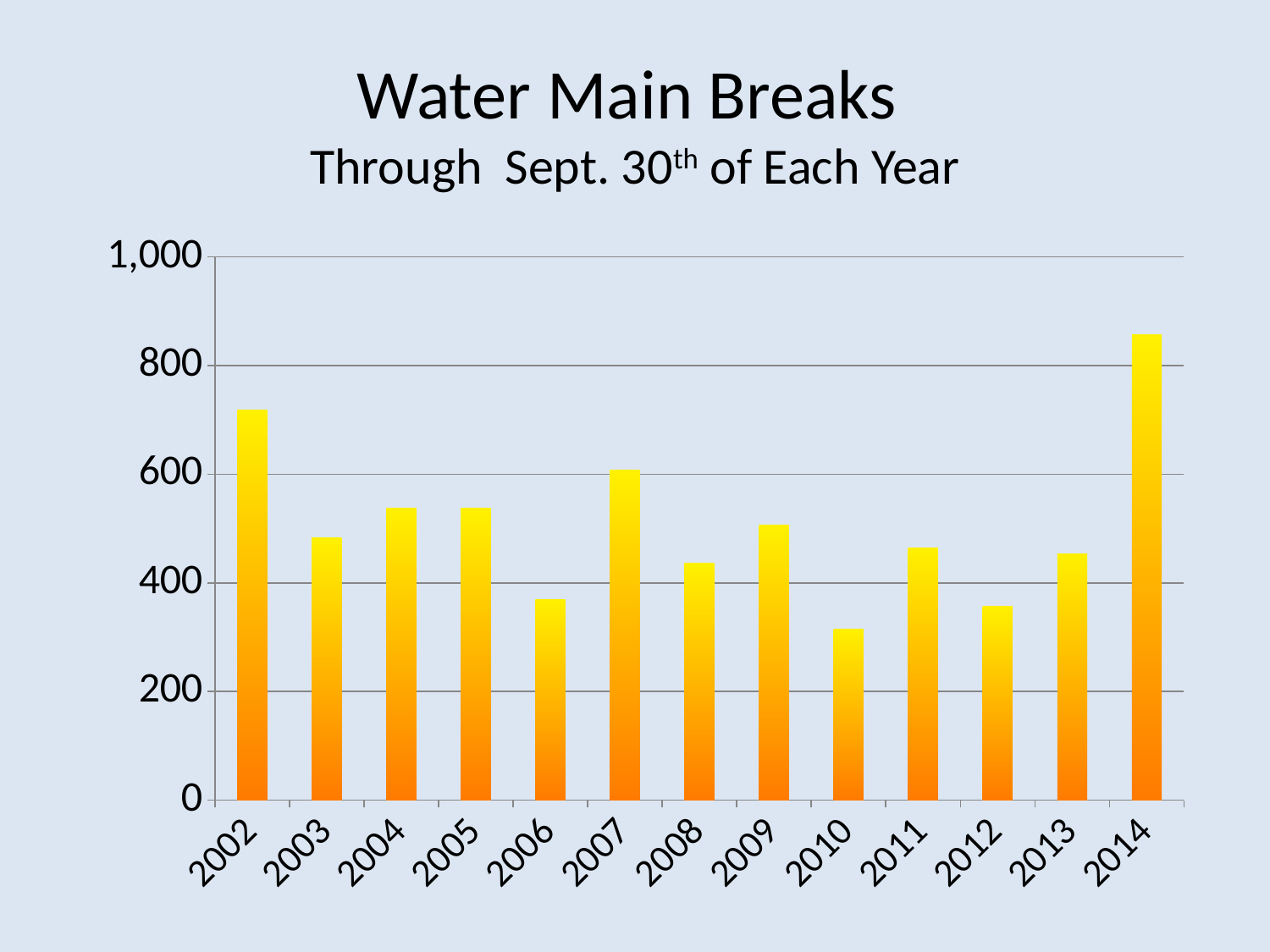
Which year has the highest number of water main breaks? 2014 Is the value for 2010 greater or less than 400? less What kind of chart is shown on the slide? bar chart How many years are shown on the x axis of the chart? 13 Is the value for 2006 greater or less than 400? less Which year has more water main breaks, 2012 or 2013? 2013 Is the value for 2014 greater or less than 800? greater Which year has the lowest number of water main breaks? 2010 What is the title of the chart? Water Main Breaks Through Sept. 30th of Each Year Which year has more water main breaks, 2002 or 2007? 2002